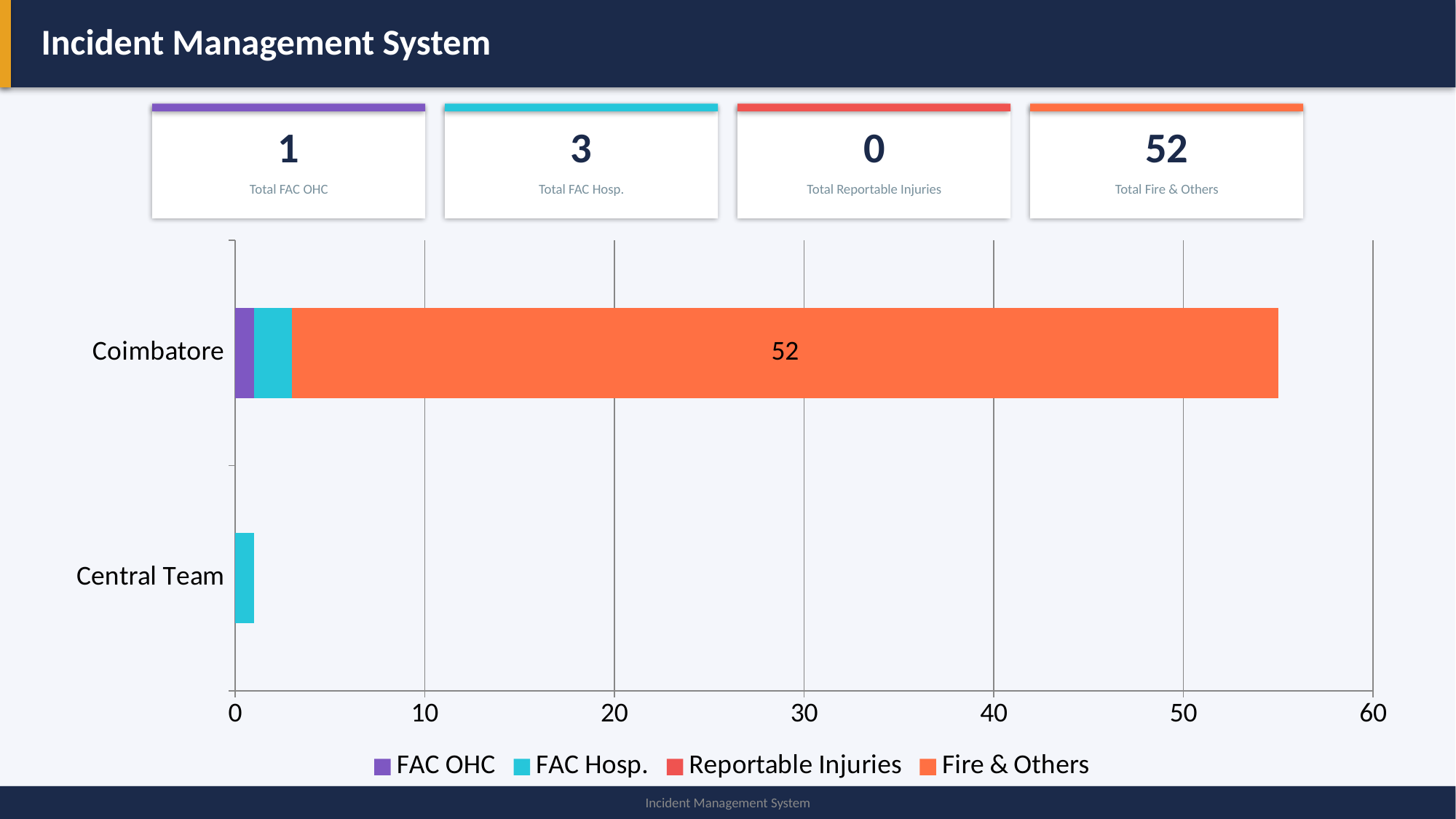
How many series does the chart legend list? 4 Which category has the longest stacked bar? Coimbatore What is the Fire & Others value for Coimbatore? 52 Is the total stacked bar for Coimbatore greater or less than 50? greater Which series is the only one visible in the Central Team bar? FAC Hosp. How many categories are shown on the vertical axis of the chart? 2 What kind of chart is shown on the slide? bar chart Which category has the shortest stacked bar? Central Team What is the highest value shown on the horizontal axis? 60 Is the total stacked bar for Central Team greater or less than 10? less Which has the larger total bar, Coimbatore or Central Team? Coimbatore